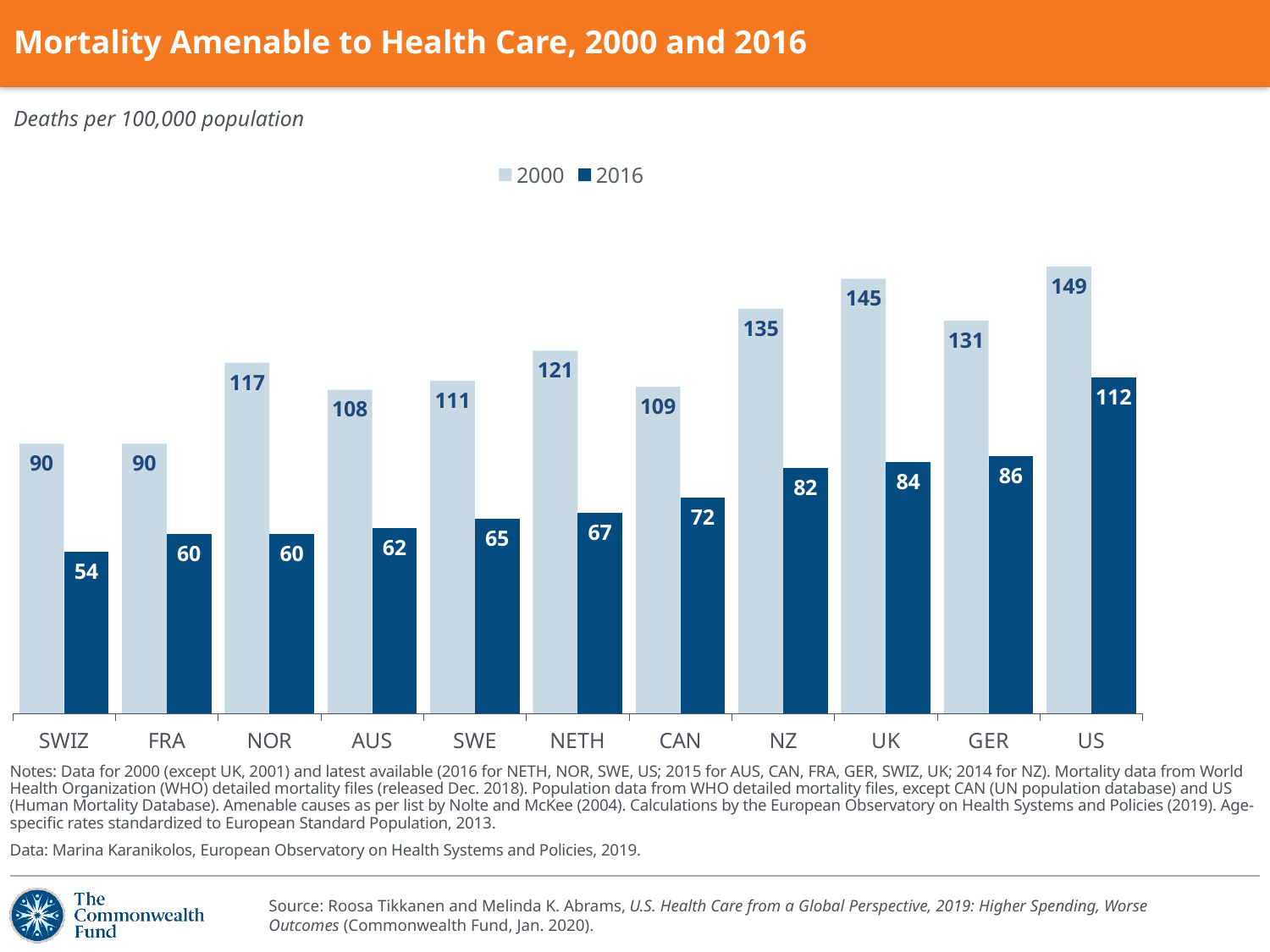
Which is larger, the 2016 value for GER or the 2016 value for NZ? GER What was the 2016 value for SWIZ? 54 What was the 2000 value for NETH? 121 What unit is stated in the subtitle of the chart? Deaths per 100,000 population Do the 2016 values rise or fall from SWIZ to US along the x axis? Rise What was the 2016 value for the US? 112 Which country had the lowest value in 2016? SWIZ Which country had the highest value in 2000? US What kind of chart is shown on the slide? Bar chart What is the difference between the 2000 and 2016 values for the UK? 61 How many countries are shown on the x axis? 11 How many series does the legend list? 2